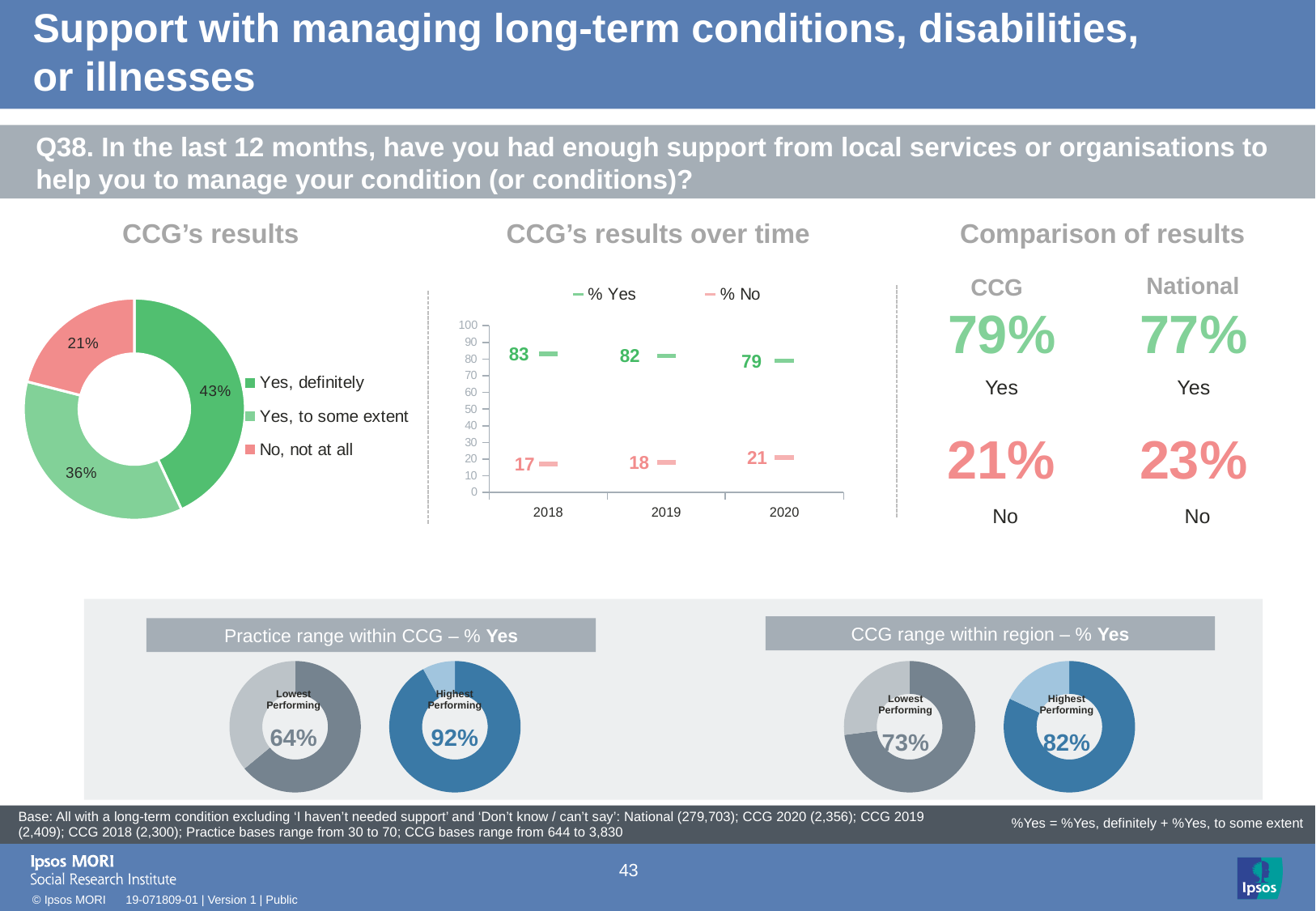
In the 'CCG's results' donut chart, how many categories does the legend list? 3 In the 'CCG's results' donut chart, which category has the largest share? Yes, definitely In the 'CCG's results over time' chart, what is the % Yes value for 2018? 83 In the 'CCG's results over time' chart, what is the difference between the % Yes values for 2018 and 2020? 4 In the 'Comparison of results' section, which is higher for % Yes, CCG or National? CCG In the 'CCG's results over time' chart, does the % Yes series rise or fall from 2018 to 2020? fall In the 'Practice range within CCG – % Yes' section, what is the Highest Performing value? 92% In the 'CCG's results' donut chart, what percentage is shown for 'No, not at all'? 21% In the 'CCG's results' donut chart, what percentage is shown for 'Yes, definitely'? 43% In the 'CCG's results over time' chart, how many series does the legend list? 2 In the 'CCG's results over time' chart, what is the % No value for 2020? 21 In the 'CCG range within region – % Yes' section, what is the Lowest Performing value? 73%